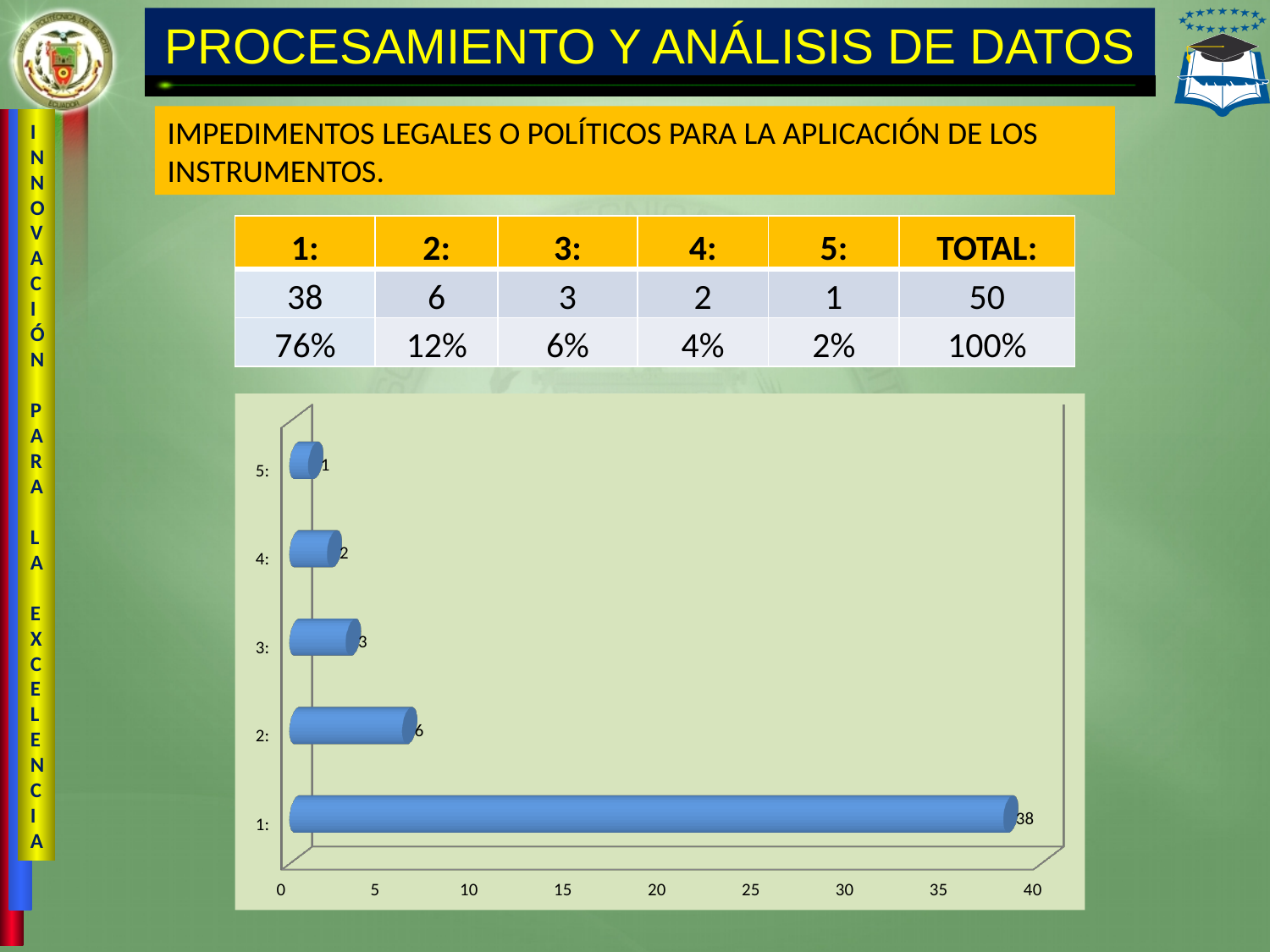
What is the value for category 5: in the bar chart? 1 Which category has the highest value in the bar chart? 1: What is the value for category 2: in the bar chart? 6 What is the maximum value shown on the horizontal axis of the bar chart? 40 What is the difference between the values for category 3: and category 4: in the bar chart? 1 Which category has the lowest value in the bar chart? 5: Is the value for category 1: in the bar chart greater or less than 35? greater How many categories are shown in the bar chart? 5 What kind of chart is shown on the slide? bar chart Which is larger in the bar chart, the value for category 2: or category 3:? 2: What is the difference between the values for category 1: and category 2: in the bar chart? 32 What is the value for category 1: in the bar chart? 38